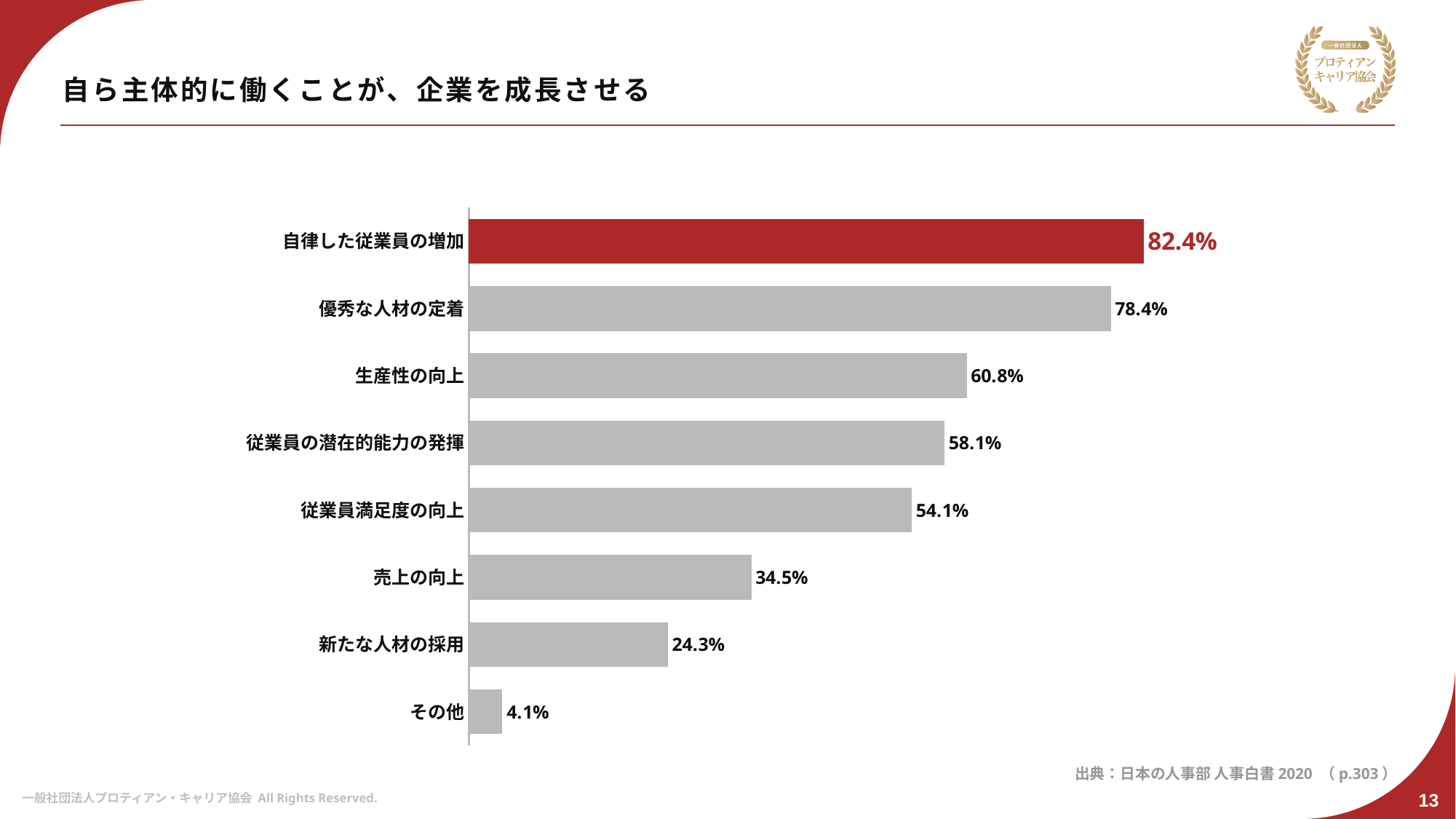
What is the difference between the values for 自律した従業員の増加 and 優秀な人材の定着? 4.0% Which bar is coloured red rather than grey? 自律した従業員の増加 What kind of chart is shown on the slide? bar chart What is the value for 従業員満足度の向上? 54.1% What is the value for 自律した従業員の増加? 82.4% Which is larger, the value for 従業員の潜在的能力の発揮 or 従業員満足度の向上? 従業員の潜在的能力の発揮 What is the value for 生産性の向上? 60.8% Which category has the highest value? 自律した従業員の増加 What is the difference between the values for 売上の向上 and 新たな人材の採用? 10.2% Which category has the lowest value? その他 How many categories are shown in the chart? 8 What is the value for 新たな人材の採用? 24.3%